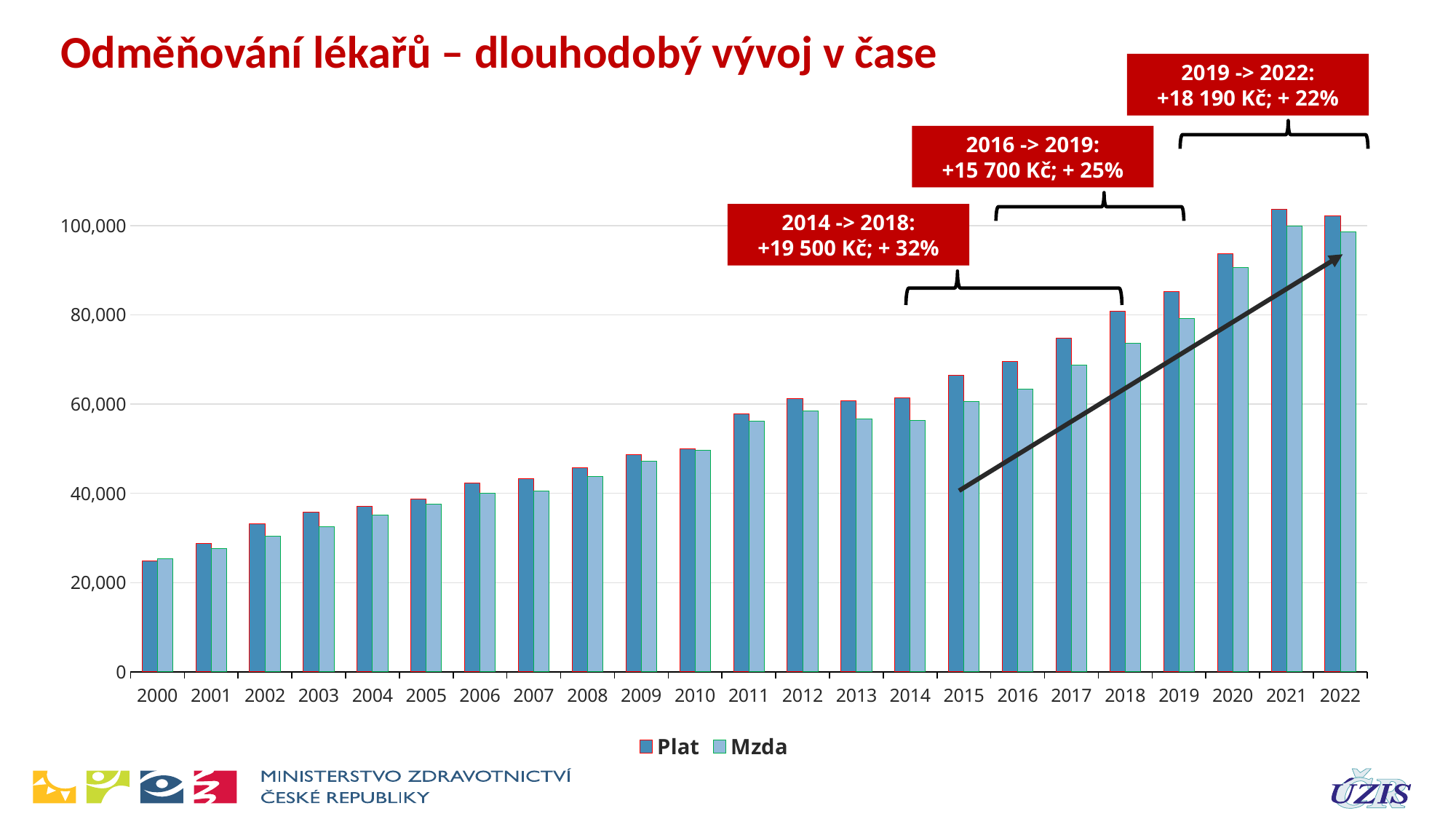
In which year is the Plat bar highest? 2021 How many series does the legend list? 2 How many years are shown on the x axis? 23 Do the Plat values generally rise or fall from 2000 to 2022? rise What are the two series named in the legend? Plat and Mzda Is the Mzda value for 2005 greater or less than 40,000? less In which year is the Mzda bar lowest? 2000 Is the Plat value for 2021 greater or less than 100,000? greater In 2022, which is larger, Plat or Mzda? Plat According to the annotation, what was the percentage increase from 2014 to 2018? + 32% Is the Plat value for 2020 greater or less than 80,000? greater What kind of chart is shown on the slide? bar chart